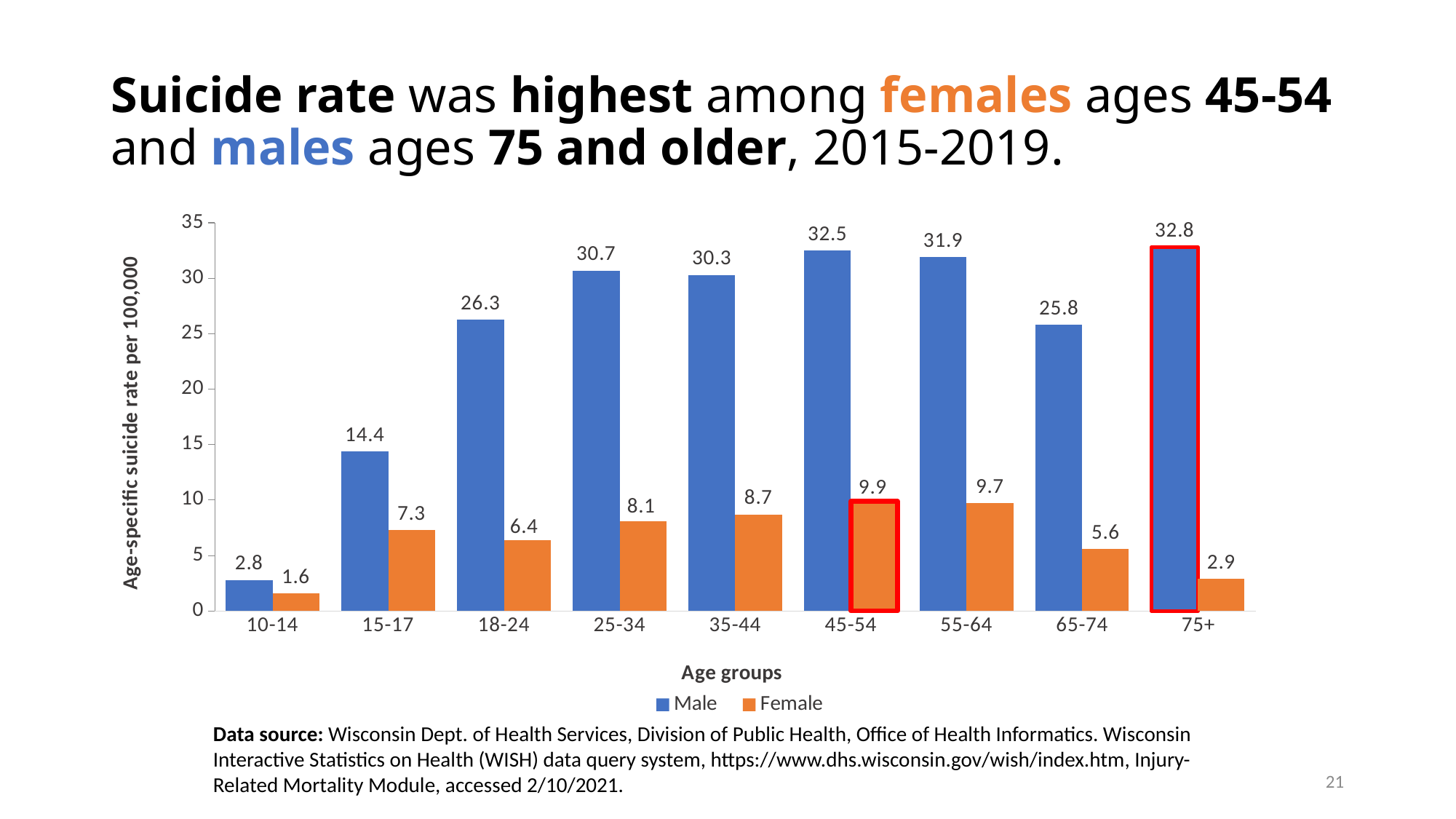
Which age group has the highest male suicide rate? 75+ Which is larger, the female rate for 35-44 or the female rate for 55-64? 55-64 What kind of chart is shown on the slide? Bar chart How many series does the legend list? 2 Which age group has the lowest female suicide rate? 10-14 What is the female suicide rate for the 15-17 age group? 7.3 What is the label of the y axis? Age-specific suicide rate per 100,000 Is the male suicide rate for the 18-24 age group greater or less than 25? greater How many age groups are shown on the x axis? 9 What is the male suicide rate for the 45-54 age group? 32.5 What is the difference between the male and female suicide rates for the 65-74 age group? 20.2 Which colour represents the Female series? Orange